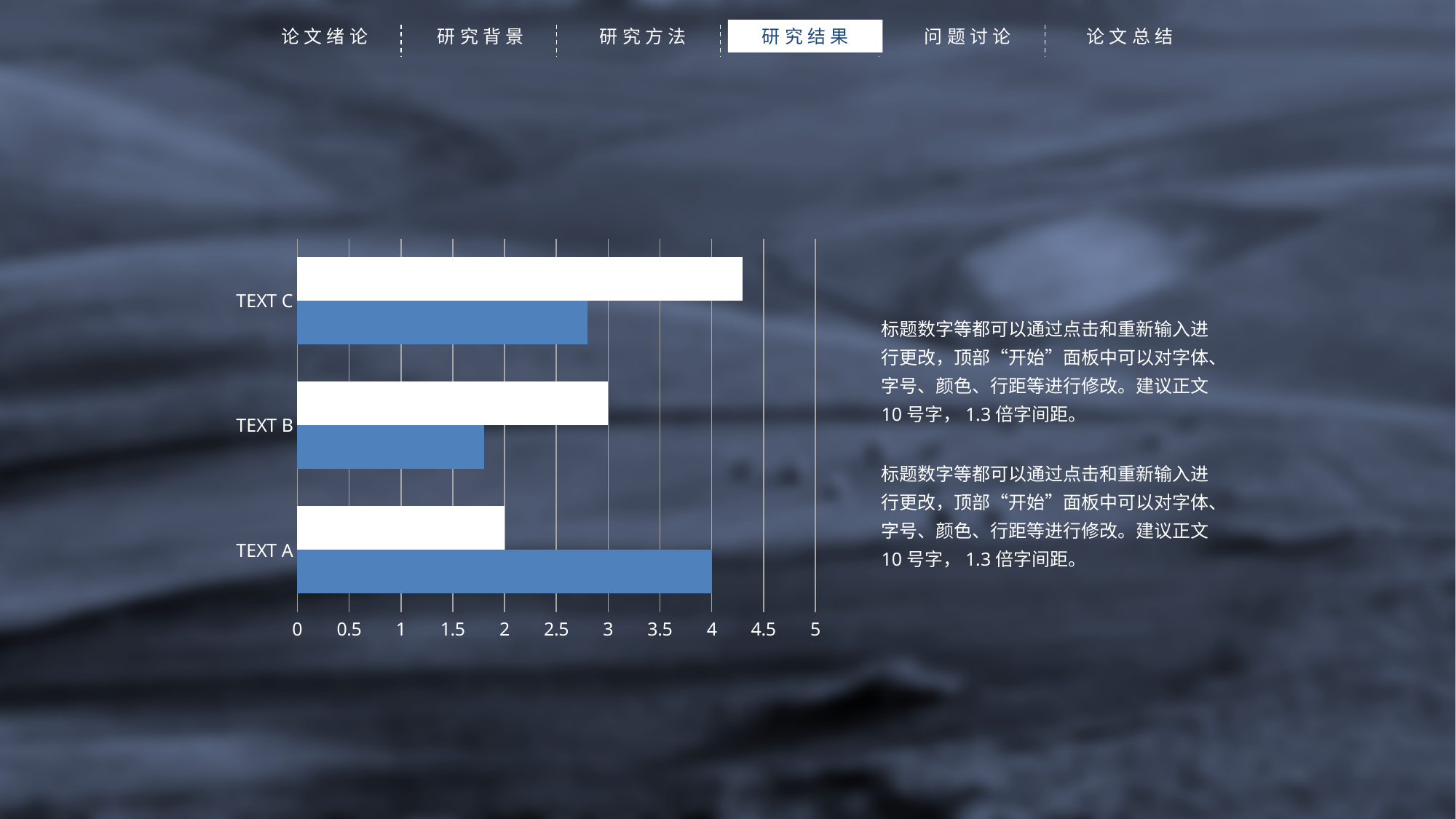
What kind of chart is shown on the slide? bar chart What is the value of the white bar for TEXT A? 2 Is the value of the blue bar for TEXT B greater or less than 2? less Which category has the shortest blue bar? TEXT B Is the value of the blue bar for TEXT C greater or less than 3? less For TEXT A, which bar is longer, the white bar or the blue bar? the blue bar What is the value of the white bar for TEXT B? 3 Which category has the longest white bar? TEXT C How many categories are shown on the chart? 3 What is the difference between the blue bar and the white bar for TEXT A? 2 What is the value of the blue bar for TEXT A? 4 Is the value of the white bar for TEXT C greater or less than 4? greater